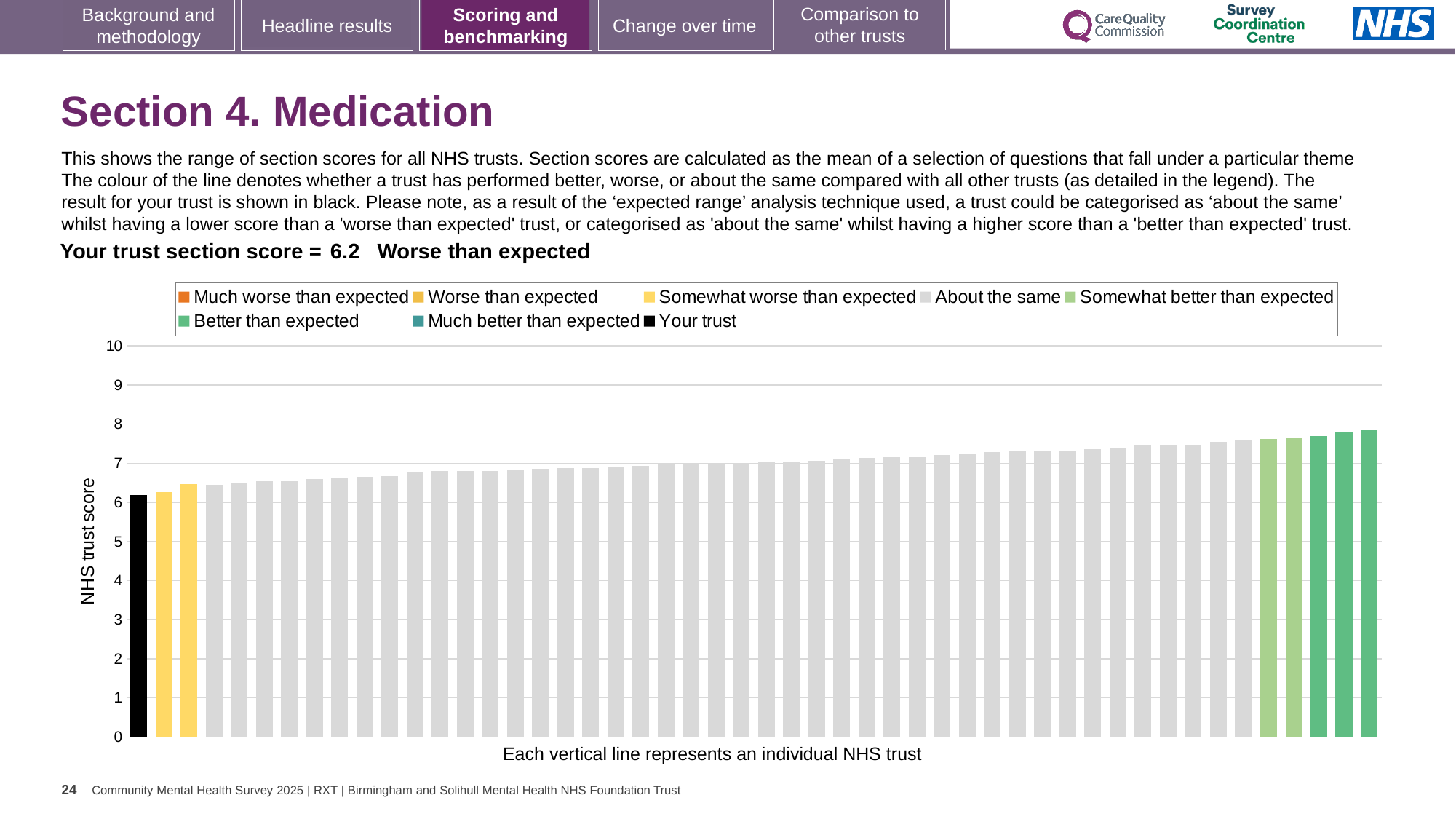
What is the label on the vertical axis of the chart? NHS trust score What is the section score for your trust shown on the chart? 6.2 What kind of chart is shown on the slide? bar chart Is the value of the tallest bar on the chart greater or less than 7? greater Which bar on the chart is the lowest? the black bar for your trust (leftmost) Which category is your trust's section score placed in? Worse than expected Do the bar values rise or fall from left to right across the chart? rise Is the value for your trust (the black bar) greater or less than 7? less How many bars on the chart are coloured yellow (Somewhat worse than expected)? 2 Which legend category does the tallest bar on the chart belong to? Better than expected How many entries does the chart legend list? 8 Is the value of the tallest bar on the chart greater or less than 8? less